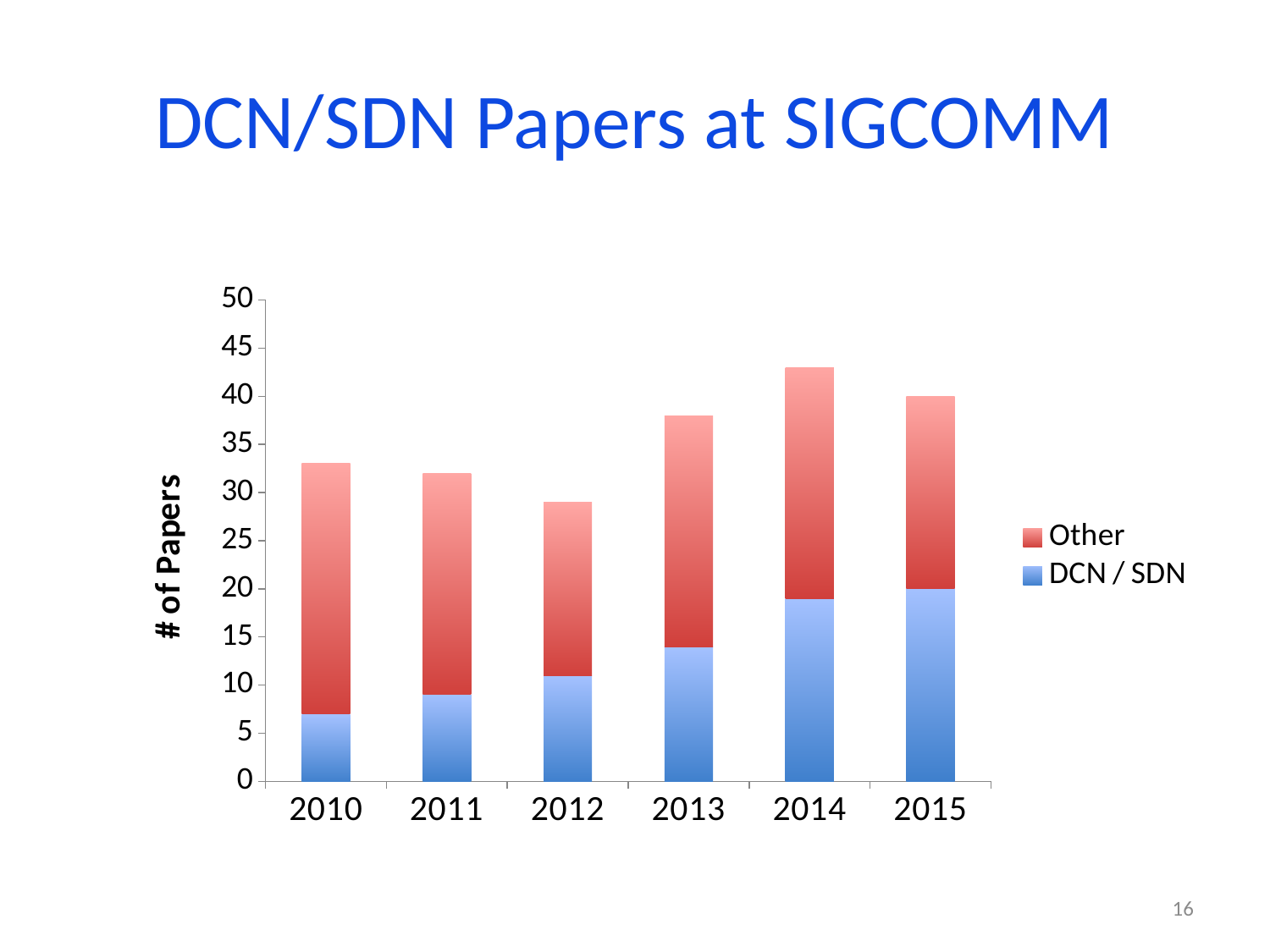
Which year has the highest total number of papers? 2014 Which year has the smallest DCN / SDN segment? 2010 What is the label on the y axis? # of Papers Which year has a larger total number of papers, 2012 or 2013? 2013 Is the total number of papers in 2014 greater or less than 40? greater How many series does the legend list? 2 Is the DCN / SDN value for 2010 greater or less than 10? less How many years are shown on the x axis? 6 Which year has the lowest total number of papers? 2012 Does the DCN / SDN series rise or fall from 2010 to 2015? rise Is the DCN / SDN value for 2015 greater or less than 15? greater What kind of chart is shown on the slide? stacked bar chart